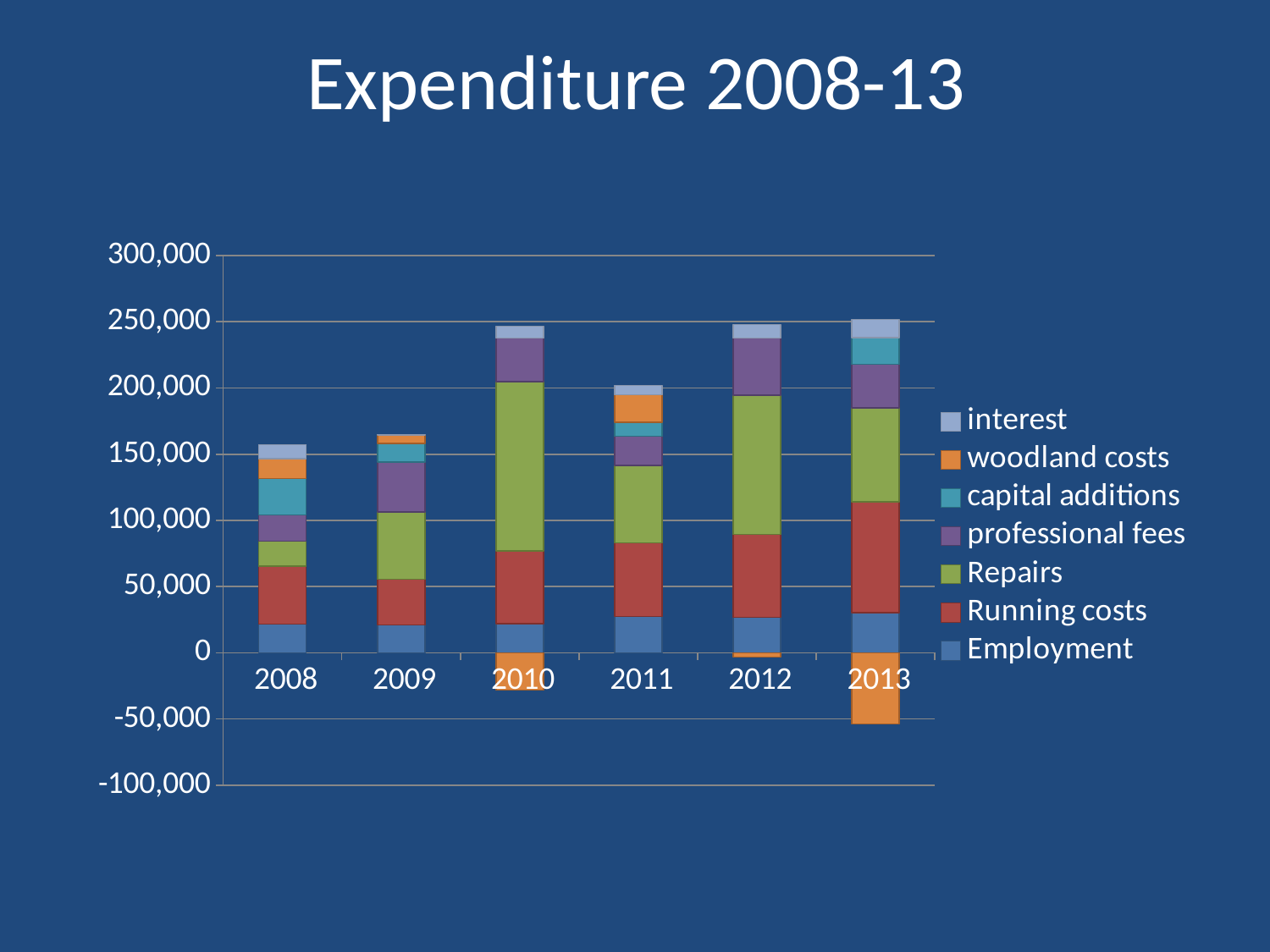
Is the Running costs segment larger in 2013 or in 2008? 2013 Is the top of the stacked bar for 2011 greater or less than 250,000? less Is the woodland costs value for 2013 greater or less than 0? less How many years are shown on the x axis of the chart? 6 Which year has the largest negative woodland costs value? 2013 What is the title of the chart? Expenditure 2008-13 How many series does the legend list? 7 Which year has the largest Repairs segment? 2010 Is the top of the stacked bar for 2010 greater or less than 200,000? greater Which colour represents Repairs in the chart? green What type of chart is shown on the slide? stacked bar chart